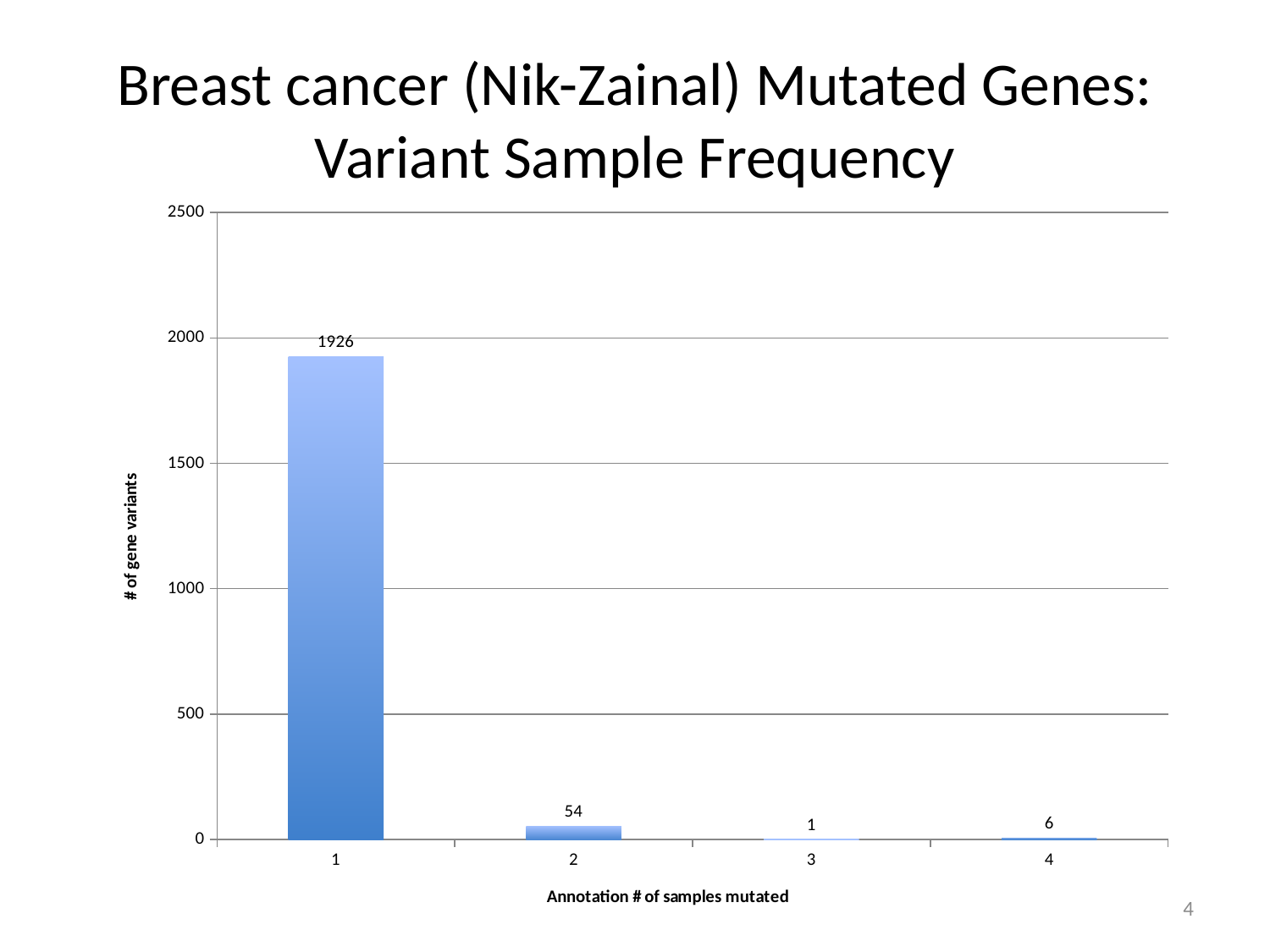
What is the number of gene variants for annotation # of samples mutated = 3? 1 Is the number of gene variants for category 1 greater or less than 1500? greater Which annotation # of samples mutated category has the highest number of gene variants? 1 What is the number of gene variants for annotation # of samples mutated = 4? 6 What kind of chart is shown on the slide? bar chart Which annotation # of samples mutated category has the lowest number of gene variants? 3 Which has more gene variants, category 2 or category 4? 2 What is the number of gene variants for annotation # of samples mutated = 1? 1926 What is the difference in number of gene variants between category 1 and category 2? 1872 What is the label of the y axis? # of gene variants How many categories are shown on the x axis? 4 What is the number of gene variants for annotation # of samples mutated = 2? 54